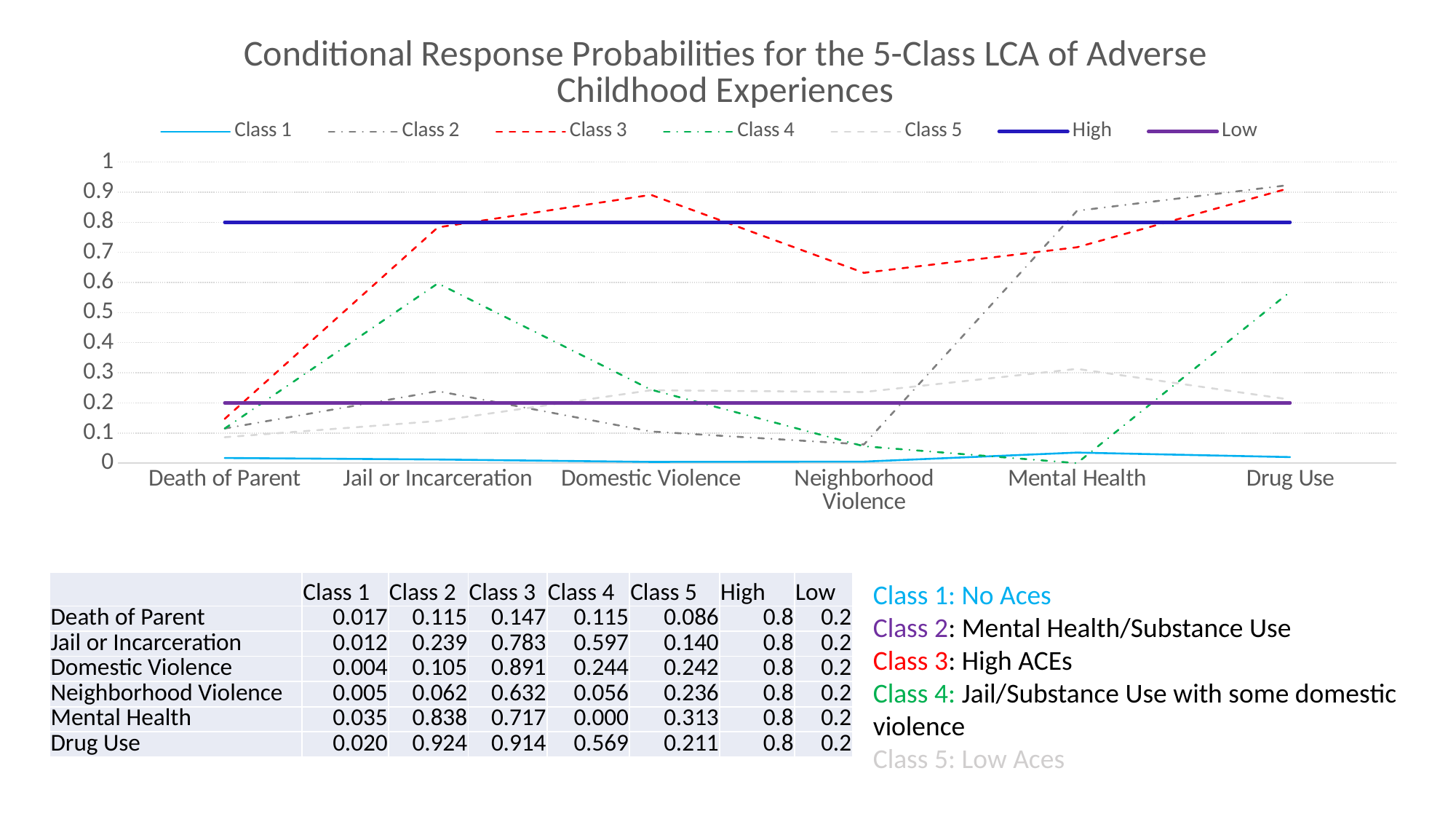
What is the Class 2 value for Mental Health? 0.838 What is the Class 5 value for Jail or Incarceration? 0.140 How many series does the chart legend list? 7 For which category is the Class 2 value highest? Drug Use Which is larger for Neighborhood Violence, the Class 3 value or the Class 2 value? Class 3 How many categories are shown along the x axis of the chart? 6 At what constant value is the High line drawn across the chart? 0.8 What is the difference between the Class 3 and Class 4 values for Jail or Incarceration? 0.186 What kind of chart is shown on the slide? line chart What is the Class 3 value for Domestic Violence? 0.891 Is the Class 3 value for Neighborhood Violence greater or less than 0.5? greater For which category is the Class 4 value lowest? Mental Health